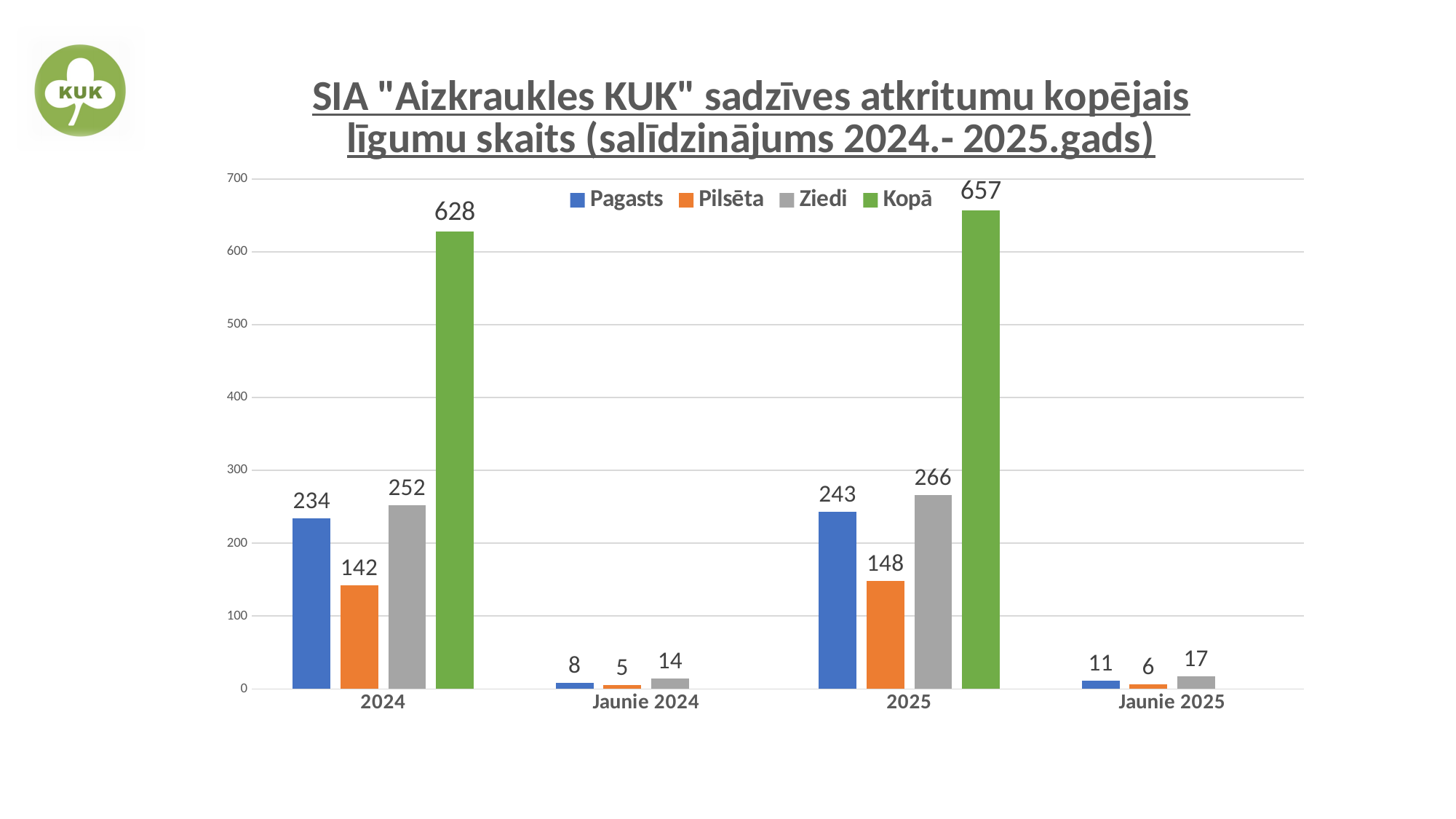
How many series does the legend list? 4 Which series is shown in green in the legend? Kopā Which category has the highest Kopā value? 2025 Which category has the lowest Pagasts value? Jaunie 2024 What is the difference between the Kopā values for 2025 and 2024? 29 What is the value for Kopā in 2025? 657 What is the value for Pagasts in 2024? 234 What kind of chart is shown on the slide? Bar chart How many categories are shown on the x axis? 4 Which is larger, Ziedi in 2024 or Pagasts in 2025? Ziedi in 2024 What is the value for Pilsēta in Jaunie 2025? 6 What is the value for Ziedi in Jaunie 2024? 14